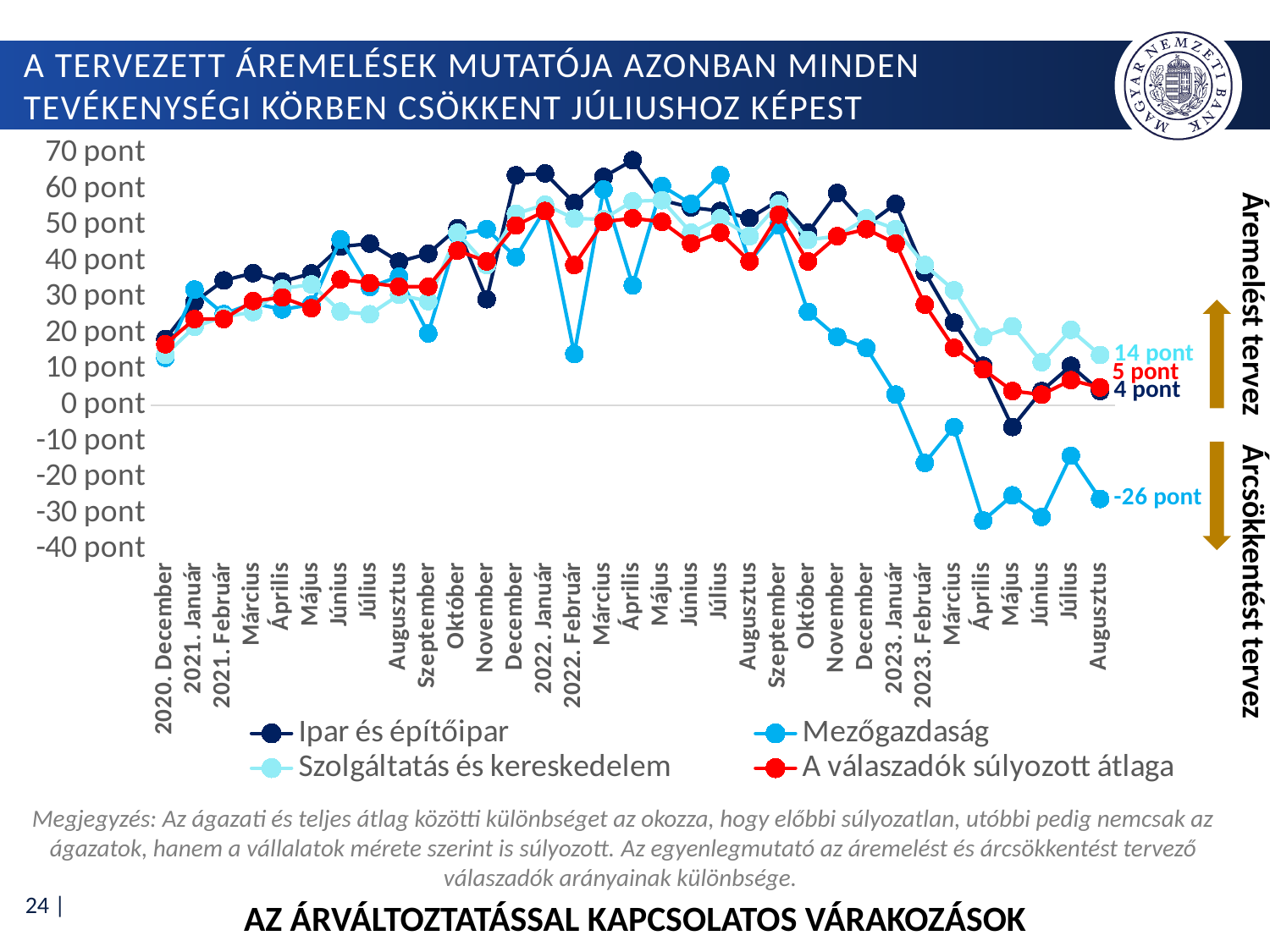
Is the value for Ipar és építőipar in 2022. Április greater or less than 60 pont? greater What is the value for A válaszadók súlyozott átlaga in 2023. Augusztus? 5 pont What is the value for Mezőgazdaság in 2023. Augusztus? -26 pont Is the value for Mezőgazdaság in 2023. Április greater or less than -20 pont? less What is the difference between the Szolgáltatás és kereskedelem and Mezőgazdaság values in 2023. Augusztus? 40 pont Which series has the lowest value in 2023. Augusztus? Mezőgazdaság How many series does the legend list? 4 What is the value for Ipar és építőipar in 2023. Augusztus? 4 pont What is the value for Szolgáltatás és kereskedelem in 2023. Augusztus? 14 pont Which series has the highest value in 2023. Augusztus? Szolgáltatás és kereskedelem In 2023. Augusztus, which is larger: Ipar és építőipar or Mezőgazdaság? Ipar és építőipar What kind of chart is shown on the slide? line chart